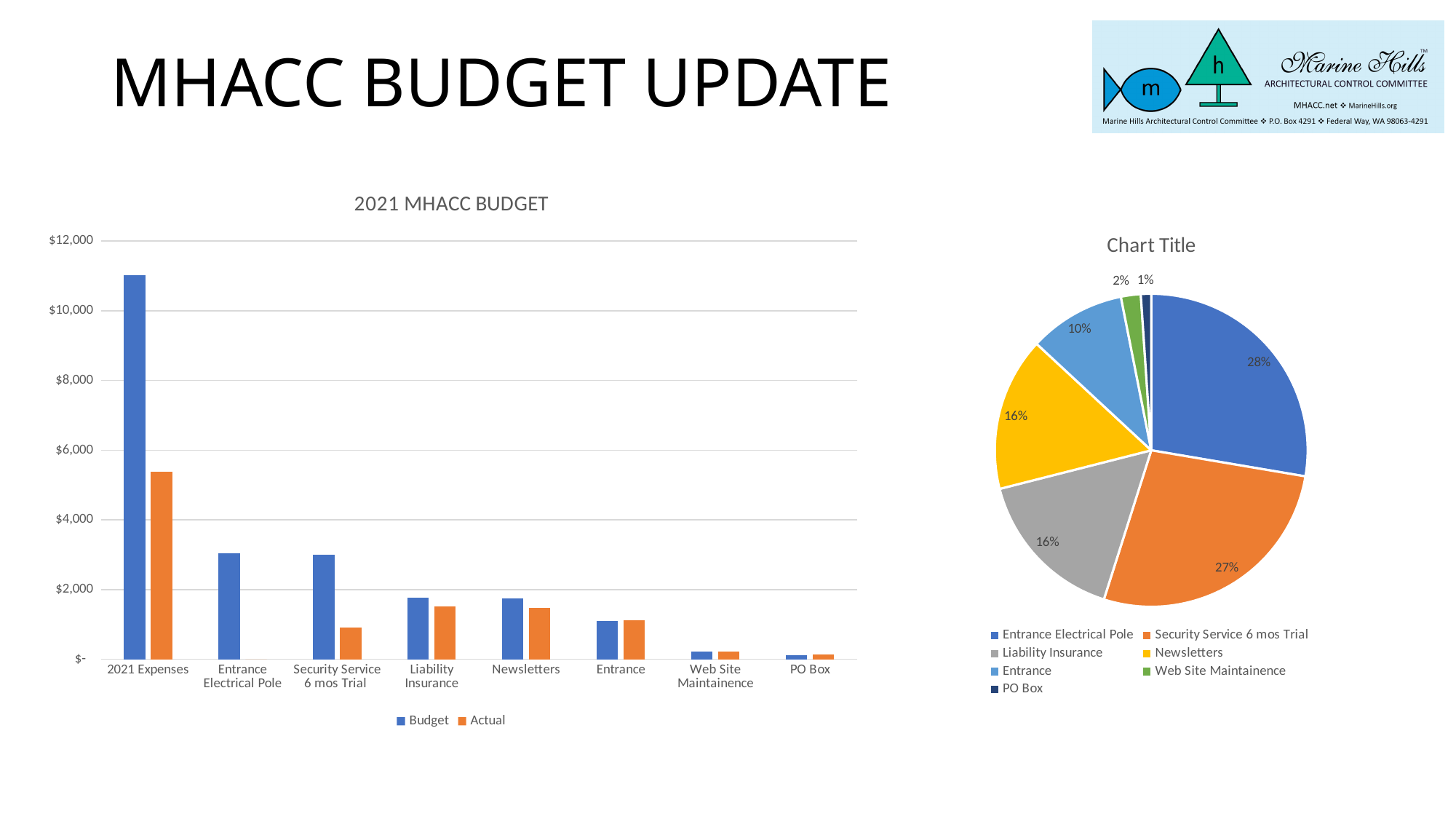
In the 2021 MHACC BUDGET chart, is the Budget value for Security Service 6 mos Trial greater or less than $2,000? greater In the 2021 MHACC BUDGET chart, how many categories are shown on the x axis? 8 In the 2021 MHACC BUDGET chart, which category has the highest Budget bar? 2021 Expenses What kind of chart is the 2021 MHACC BUDGET chart? bar chart In the 2021 MHACC BUDGET chart, is the Budget value for 2021 Expenses greater or less than $10,000? greater In the 2021 MHACC BUDGET chart, is the Actual value for 2021 Expenses greater or less than $6,000? less In the pie chart titled Chart Title, what share does Entrance Electrical Pole have? 28% In the pie chart titled Chart Title, which slice is the smallest? PO Box In the pie chart titled Chart Title, how many slices are there? 7 In the pie chart titled Chart Title, what share does Security Service 6 mos Trial have? 27% In the 2021 MHACC BUDGET bar chart, how many series does the legend list? 2 In the 2021 MHACC BUDGET chart, which is larger for Security Service 6 mos Trial, the Budget bar or the Actual bar? Budget